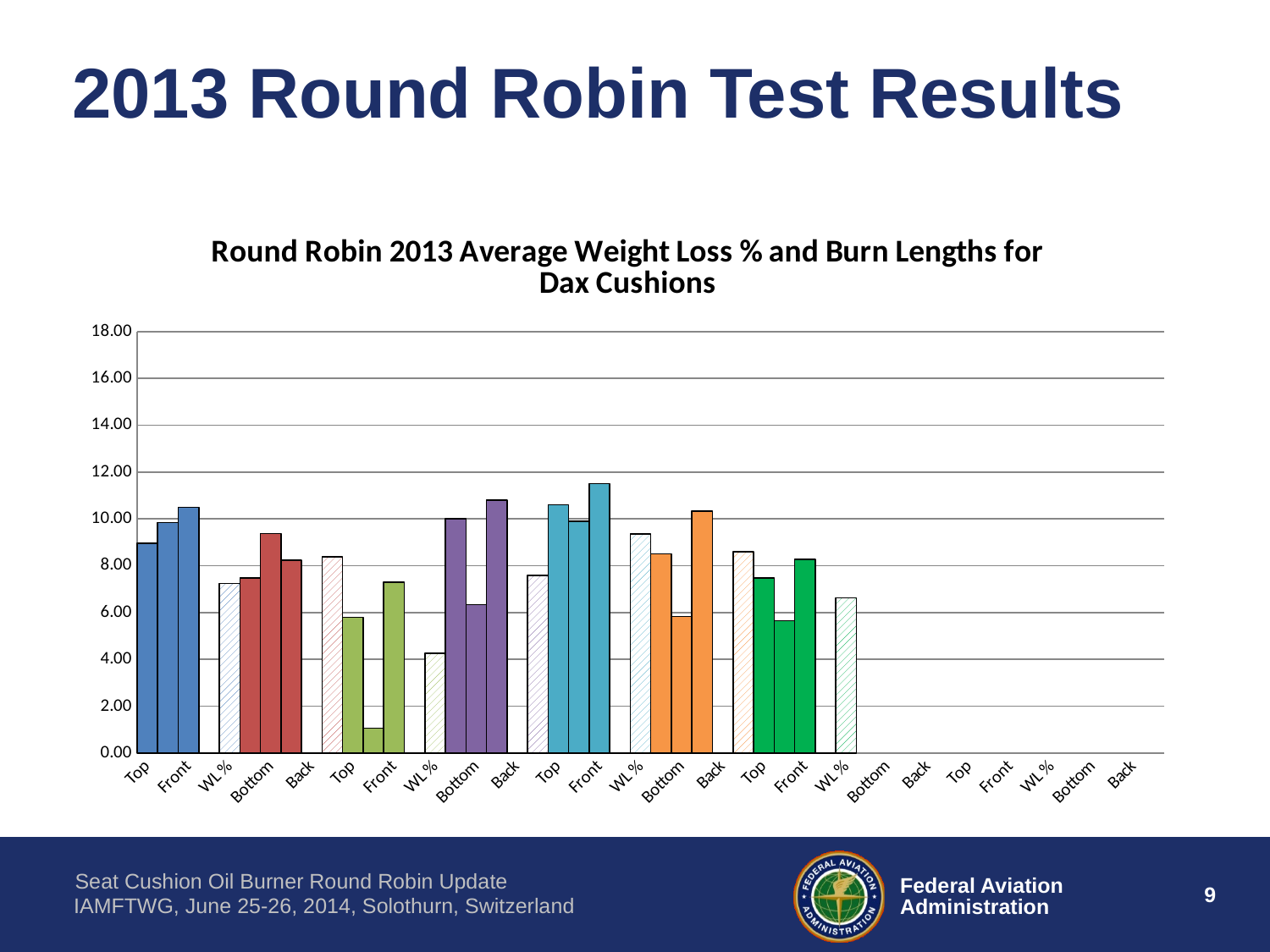
What is the title of the chart? Round Robin 2013 Average Weight Loss % and Burn Lengths for Dax Cushions What kind of chart is shown on the slide? bar chart In the first (blue) group, which is larger, the Top bar or the Front bar? Front Which bar is the shortest among the plotted bars? the middle green bar in the third group (the short bar between the Top and Front labels) Is the value for the last WL % bar (seventh group) greater or less than 6.00? greater Is the value for the teal Front bar in the fifth group greater or less than 10.00? greater What is the highest value shown on the vertical axis? 18.00 Is the value for the first (blue) Top bar greater or less than 8.00? greater Which bar is the tallest in the chart? the teal Front bar (fifth group)